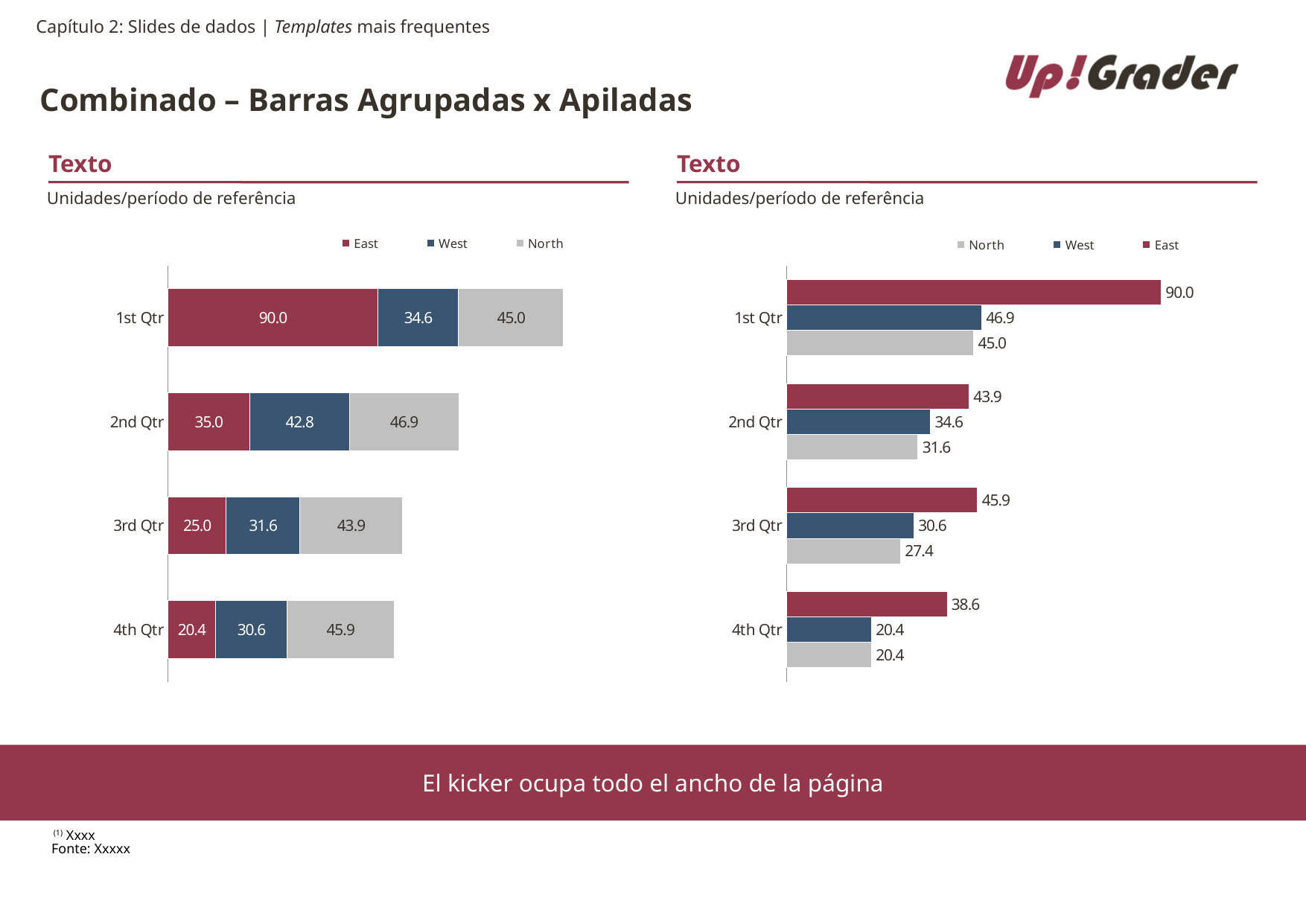
In the stacked bar chart on the left, what is the total of the 3rd Qtr bar? 100.5 In the stacked bar chart on the left, what is the East value for 2nd Qtr? 35.0 In the grouped bar chart on the right, what is the West value for 1st Qtr? 46.9 In the stacked bar chart on the left, what is the difference between the West values for 2nd Qtr and 4th Qtr? 12.2 In the stacked bar chart on the left, which quarter has the highest East value? 1st Qtr In the stacked bar chart on the left, what is the North value for 4th Qtr? 45.9 In the stacked bar chart on the left, what is the total of the 1st Qtr bar? 169.6 In the grouped bar chart on the right, which is larger for 3rd Qtr: the West value or the North value? West In the grouped bar chart on the right, what is the East value for 4th Qtr? 38.6 In the grouped bar chart on the right, which quarter has the lowest North value? 4th Qtr In the grouped bar chart on the right, how many series does the legend list? 3 What kind of chart is shown on the left side of the slide? Stacked bar chart